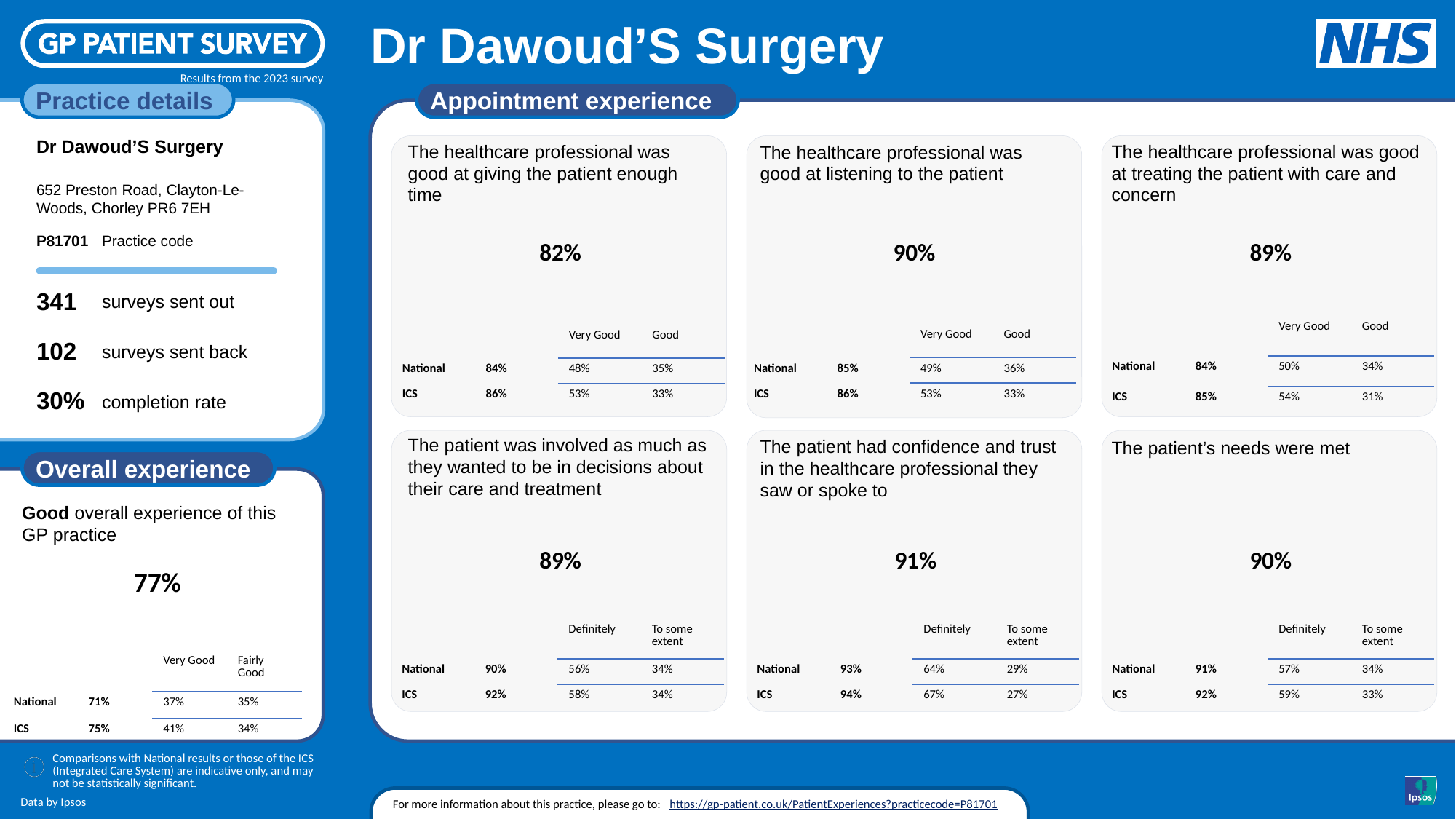
In the 'Appointment experience' section, which of the six measures has the lowest practice value? The healthcare professional was good at giving the patient enough time In the 'Appointment experience' section, what is the difference between the practice value for 'The patient's needs were met' and the National value for that measure? 1 percentage point In the 'Appointment experience' section, what is the practice's value for 'The healthcare professional was good at giving the patient enough time'? 82% In the 'Appointment experience' section, what is the practice's value for 'The patient had confidence and trust in the healthcare professional they saw or spoke to'? 91% How many measures are shown in the 'Appointment experience' section? 6 In the 'Overall experience' panel, what is the ICS 'Very Good' value? 41% In the 'Appointment experience' section, which of the six measures has the highest practice value? The patient had confidence and trust in the healthcare professional they saw or spoke to In the 'Overall experience' panel, what is the National value for good overall experience? 71% In the 'Appointment experience' section, is the practice value for 'The healthcare professional was good at listening to the patient' higher or lower than the National value? higher In the 'Overall experience' panel, what is the difference between the practice value (77%) and the National value (71%)? 6 percentage points In the 'Appointment experience' section, what is the ICS 'Definitely' value for 'The patient was involved as much as they wanted to be in decisions about their care and treatment'? 58% In the 'Overall experience' panel, what percentage of patients reported a good overall experience of this GP practice? 77%